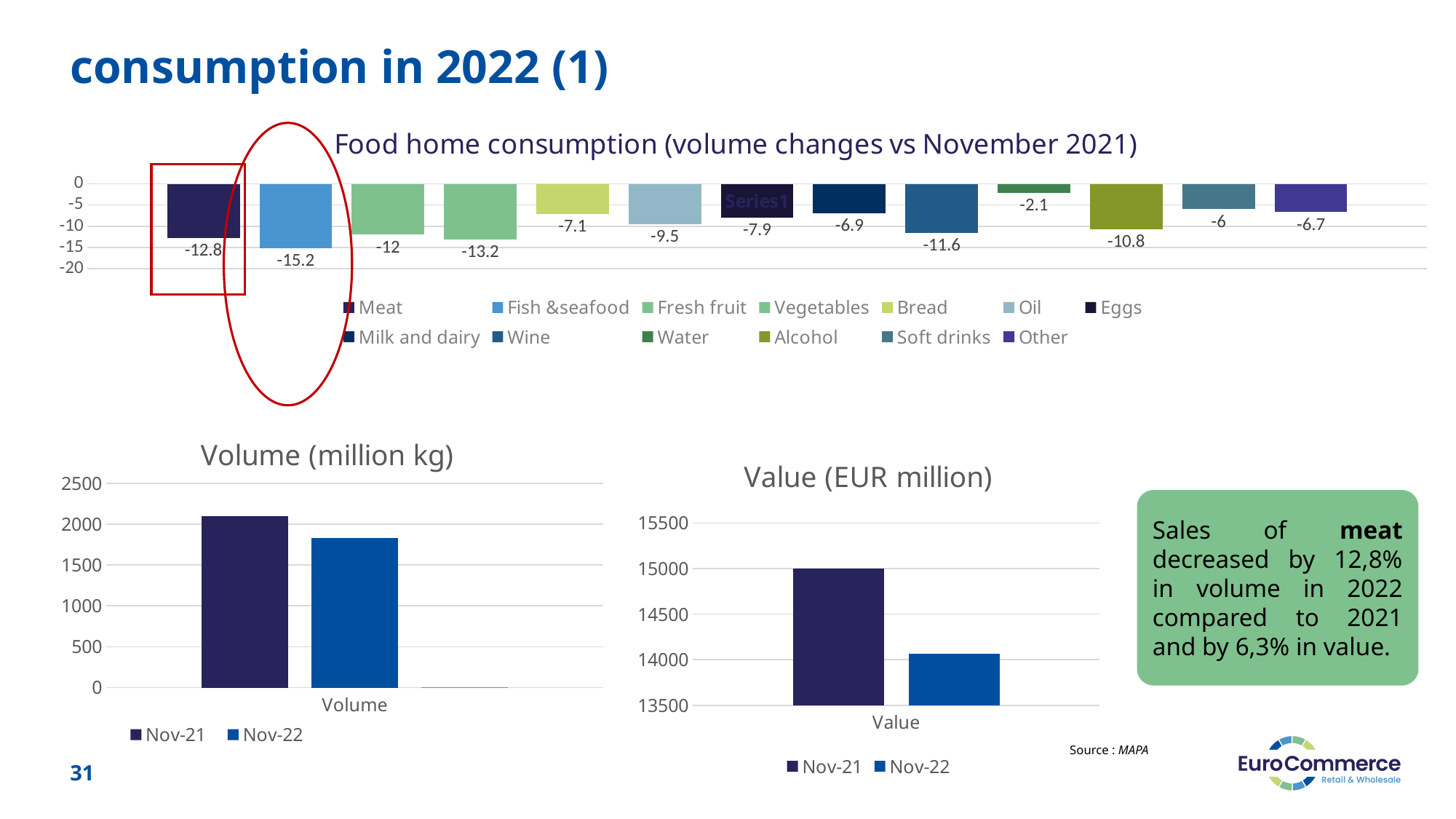
In the 'Food home consumption (volume changes vs November 2021)' chart, which shows a larger decline, Wine or Alcohol? Wine In the 'Food home consumption (volume changes vs November 2021)' chart, what is the value for Water? -2.1 In the 'Food home consumption (volume changes vs November 2021)' chart, which category has the lowest value (largest decline)? Fish & seafood How many categories are plotted in the 'Food home consumption (volume changes vs November 2021)' chart? 13 How many series does the legend of the 'Volume (million kg)' chart list? 2 In the 'Volume (million kg)' chart, is the value for Nov-21 greater or less than 2000? greater In the 'Food home consumption (volume changes vs November 2021)' chart, which category has the highest value (smallest decline)? Water In the 'Value (EUR million)' chart, is the value for Nov-22 greater or less than 14500? less In the 'Food home consumption (volume changes vs November 2021)' chart, what is the value for Fish & seafood? -15.2 In the 'Food home consumption (volume changes vs November 2021)' chart, what is the difference between the values for Meat and Fish & seafood? 2.4 In the 'Food home consumption (volume changes vs November 2021)' chart, what is the value for Meat? -12.8 What kind of chart is the 'Value (EUR million)' chart? Bar chart